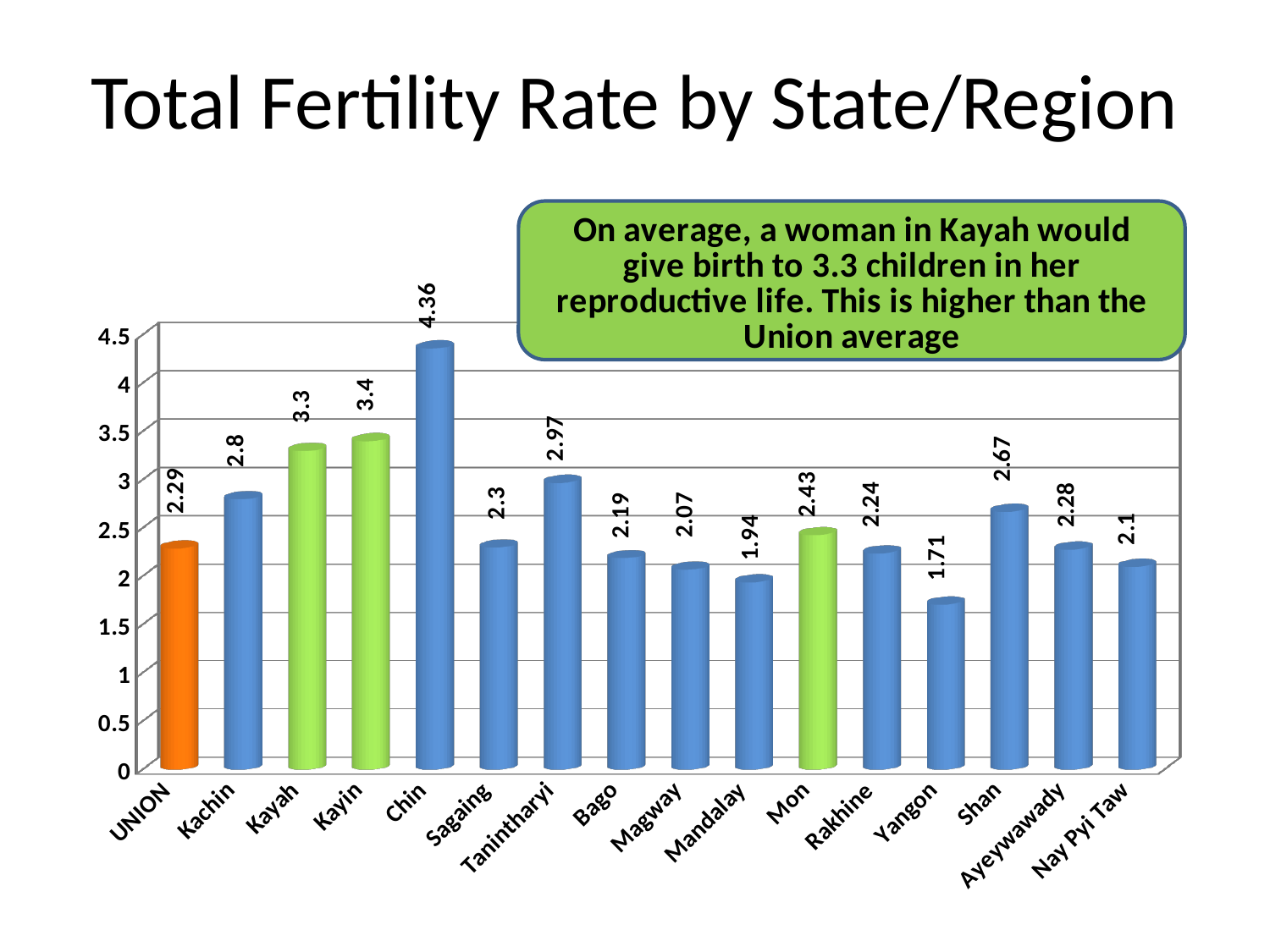
Which bar is coloured orange? UNION What kind of chart is shown on the slide? bar chart What is the total fertility rate for Kayah? 3.3 Which has a higher total fertility rate, Kachin or Shan? Kachin Which state/region has the lowest total fertility rate? Yangon What is the difference between the total fertility rate of Chin and the UNION? 2.07 What is the total fertility rate for the UNION? 2.29 Which state/region has the highest total fertility rate? Chin How many bars are shown in the chart? 16 What is the difference between the total fertility rate of Kayin and Kayah? 0.1 What is the total fertility rate for Yangon? 1.71 Is the value for Tanintharyi greater or less than 3? less